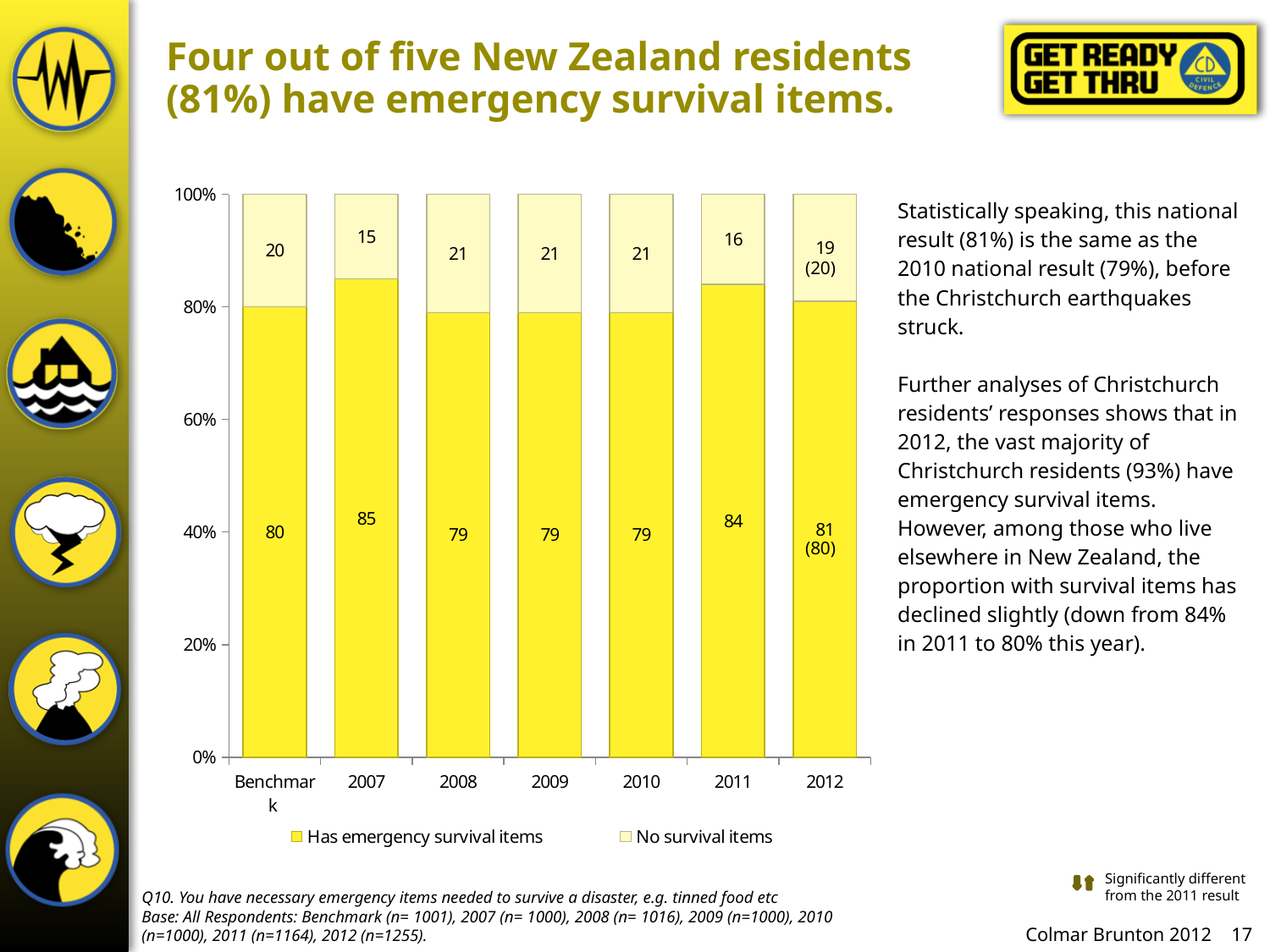
What kind of chart is shown on the slide? Stacked bar chart How many series does the legend list? 2 Is the 'Has emergency survival items' value for 2012 larger than the value for 2009? Yes, 2012 (81) is larger than 2009 (79) Which year has the highest value for 'Has emergency survival items'? 2007 Which category has the lowest value for 'No survival items'? 2007 What is the value for 'Has emergency survival items' in 2007? 85 Is the 'Has emergency survival items' value for 2008 greater or less than 80%? less How many categories are shown on the x axis? 7 What is the value for 'Has emergency survival items' in the Benchmark category? 80 What is the difference between the 'Has emergency survival items' values for 2011 and 2010? 5 What are the two legend entries of the chart? Has emergency survival items; No survival items What is the value for 'No survival items' in 2011? 16